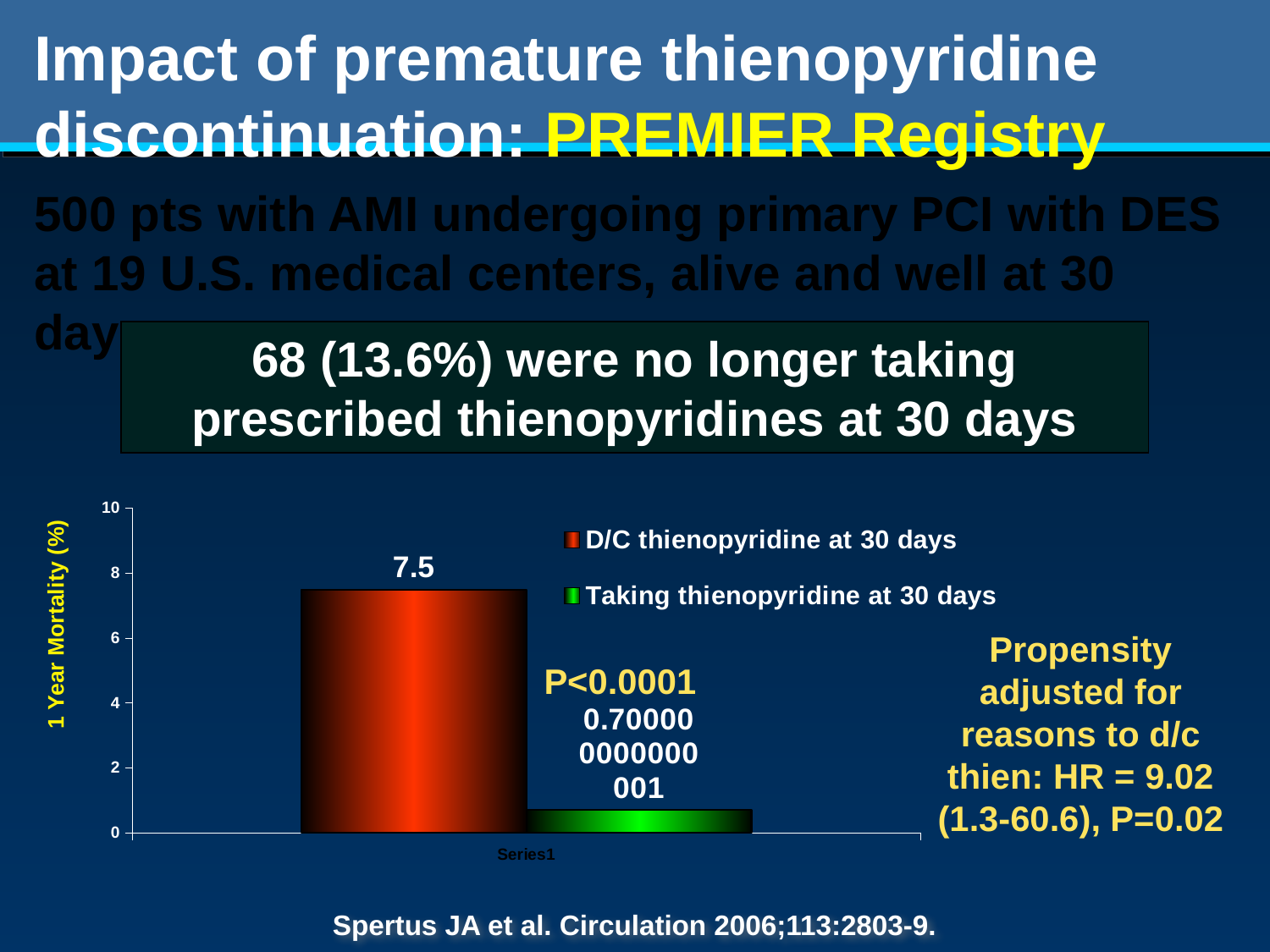
What is the 1 year mortality (%) for the D/C thienopyridine at 30 days group? 7.5 Is the value for Taking thienopyridine at 30 days greater or less than 2? less How many bars are plotted in the chart? 2 What is the label on the vertical axis of the chart? 1 Year Mortality (%) Which colour represents the Taking thienopyridine at 30 days group in the chart? Green Which group has the higher 1 year mortality? D/C thienopyridine at 30 days How many series does the chart legend list? 2 What kind of chart is shown on the slide? Bar chart Is the 1 year mortality higher for patients who discontinued thienopyridine at 30 days or for those still taking it at 30 days? D/C thienopyridine at 30 days Which group has the lower 1 year mortality? Taking thienopyridine at 30 days Is the value for D/C thienopyridine at 30 days greater or less than 8? less Is the value for D/C thienopyridine at 30 days greater or less than 6? greater